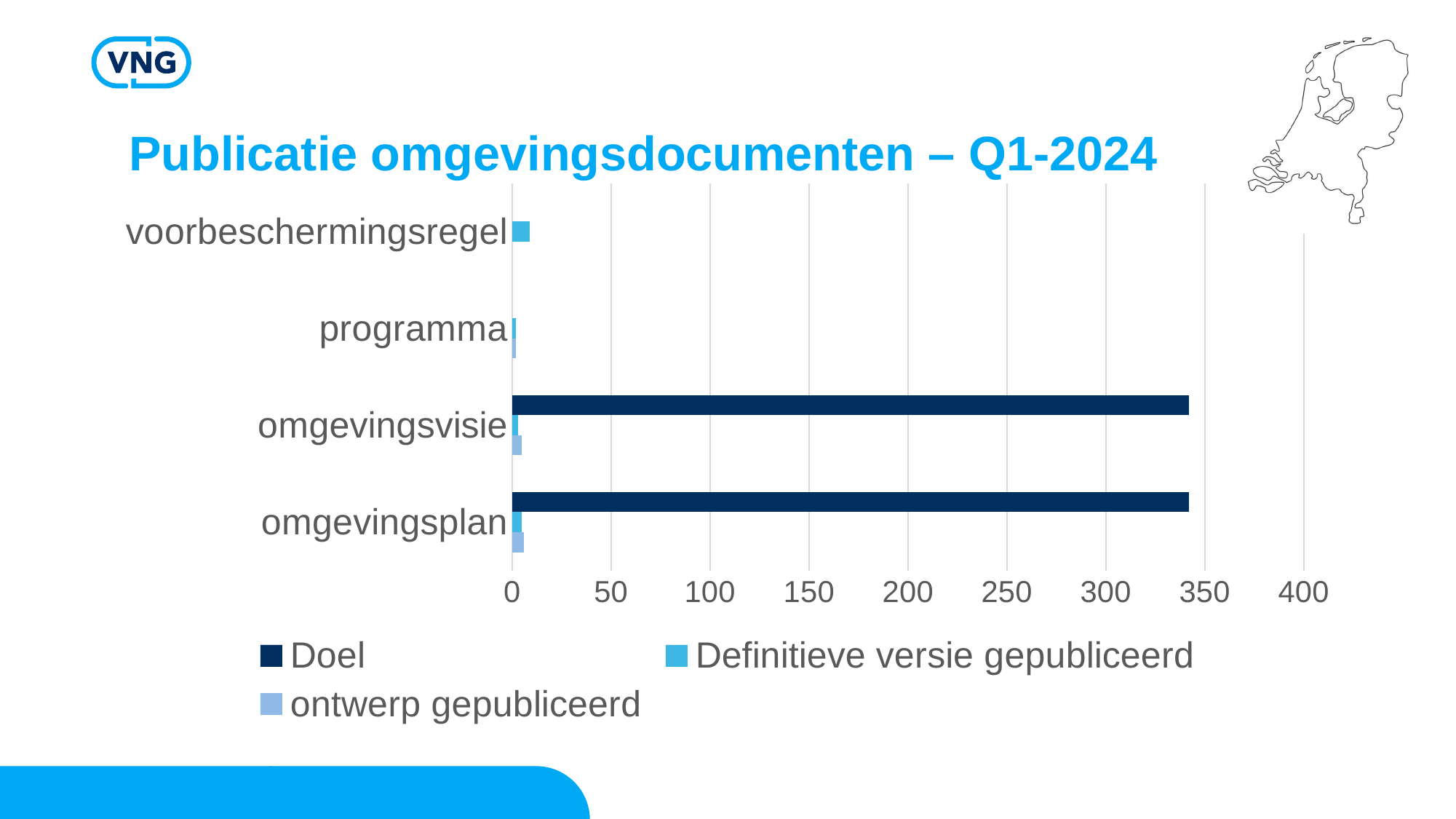
What kind of chart is shown on the slide? bar chart Is the 'ontwerp gepubliceerd' value for omgevingsplan greater or less than 50? less What is the title of the chart on the slide? Publicatie omgevingsdocumenten – Q1-2024 How many series does the chart legend list? 3 Which series is shown in dark navy blue in the chart? Doel Which is larger: the Doel value for omgevingsvisie or the 'ontwerp gepubliceerd' value for programma? Doel value for omgevingsvisie What is the highest value shown on the horizontal axis of the chart? 400 Is the Doel value for omgevingsplan greater or less than 300? greater Is the Doel value for omgevingsvisie greater or less than 350? less How many categories are shown on the vertical axis of the chart? 4 For omgevingsplan, which is larger: the Doel value or the 'Definitieve versie gepubliceerd' value? Doel